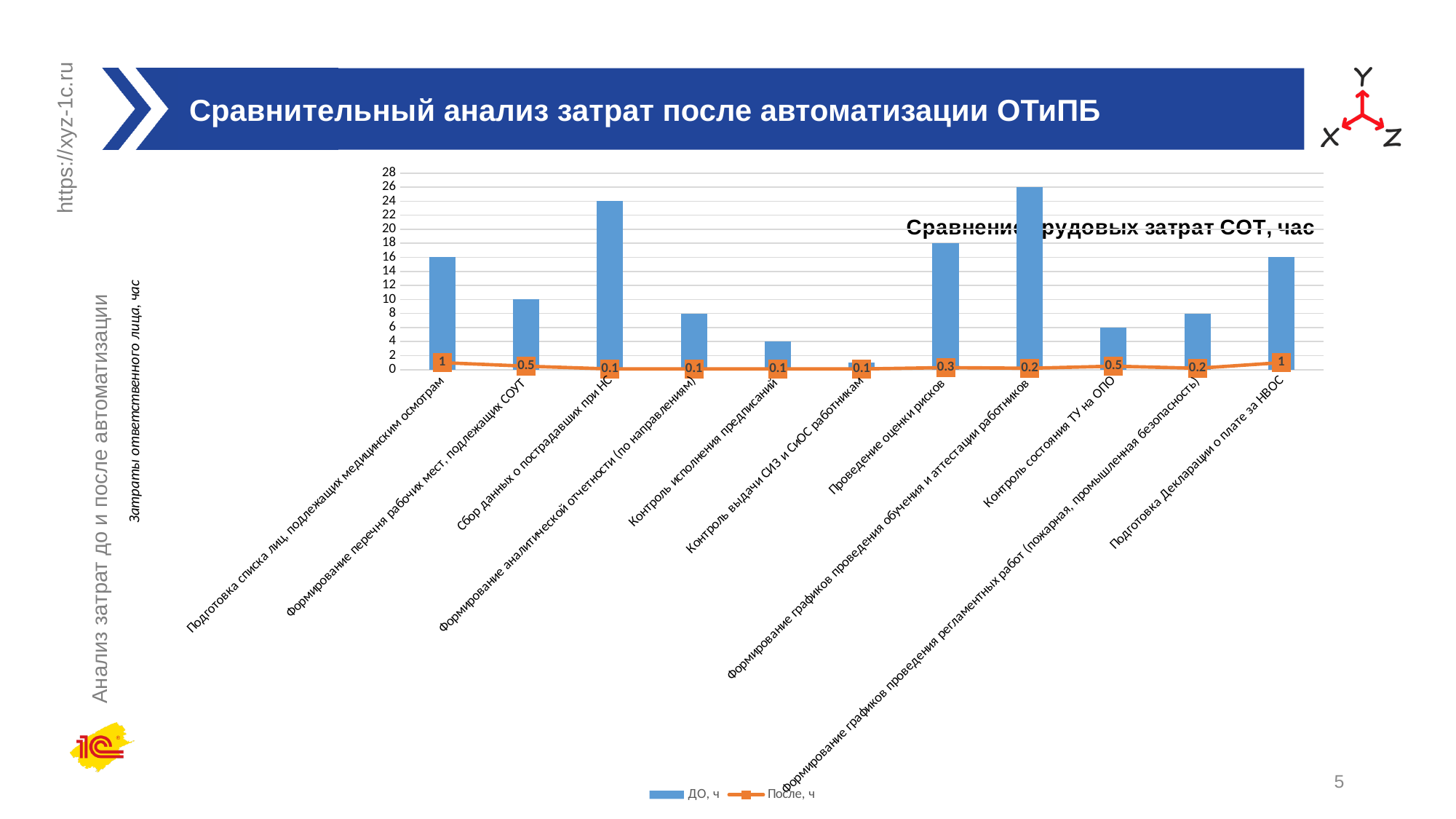
Which category has the highest 'ДО, ч' bar? Формирование графиков проведения обучения и аттестации работников What is the value of the 'ДО, ч' bar for 'Контроль состояния ТУ на ОПО'? 6 What is the difference between the 'После, ч' values for 'Подготовка списка лиц, подлежащих медицинским осмотрам' and 'Формирование перечня рабочих мест, подлежащих СОУТ'? 0.5 What is the value of the 'После, ч' series for 'Проведение оценки рисков'? 0.3 How many series does the chart legend list? 2 What is the value of the 'ДО, ч' bar for 'Сбор данных о пострадавших при НС'? 24 What is the value of the 'После, ч' series for 'Подготовка списка лиц, подлежащих медицинским осмотрам'? 1 What kind of chart is shown on the slide? A bar chart combined with a line chart How many categories are shown on the x axis of the chart? 11 Is the 'ДО, ч' value for 'Проведение оценки рисков' greater or less than 10? greater Which has the larger 'ДО, ч' value: 'Сбор данных о пострадавших при НС' or 'Формирование перечня рабочих мест, подлежащих СОУТ'? Сбор данных о пострадавших при НС Which category has the lowest 'ДО, ч' bar? Контроль выдачи СИЗ и СиОС работникам